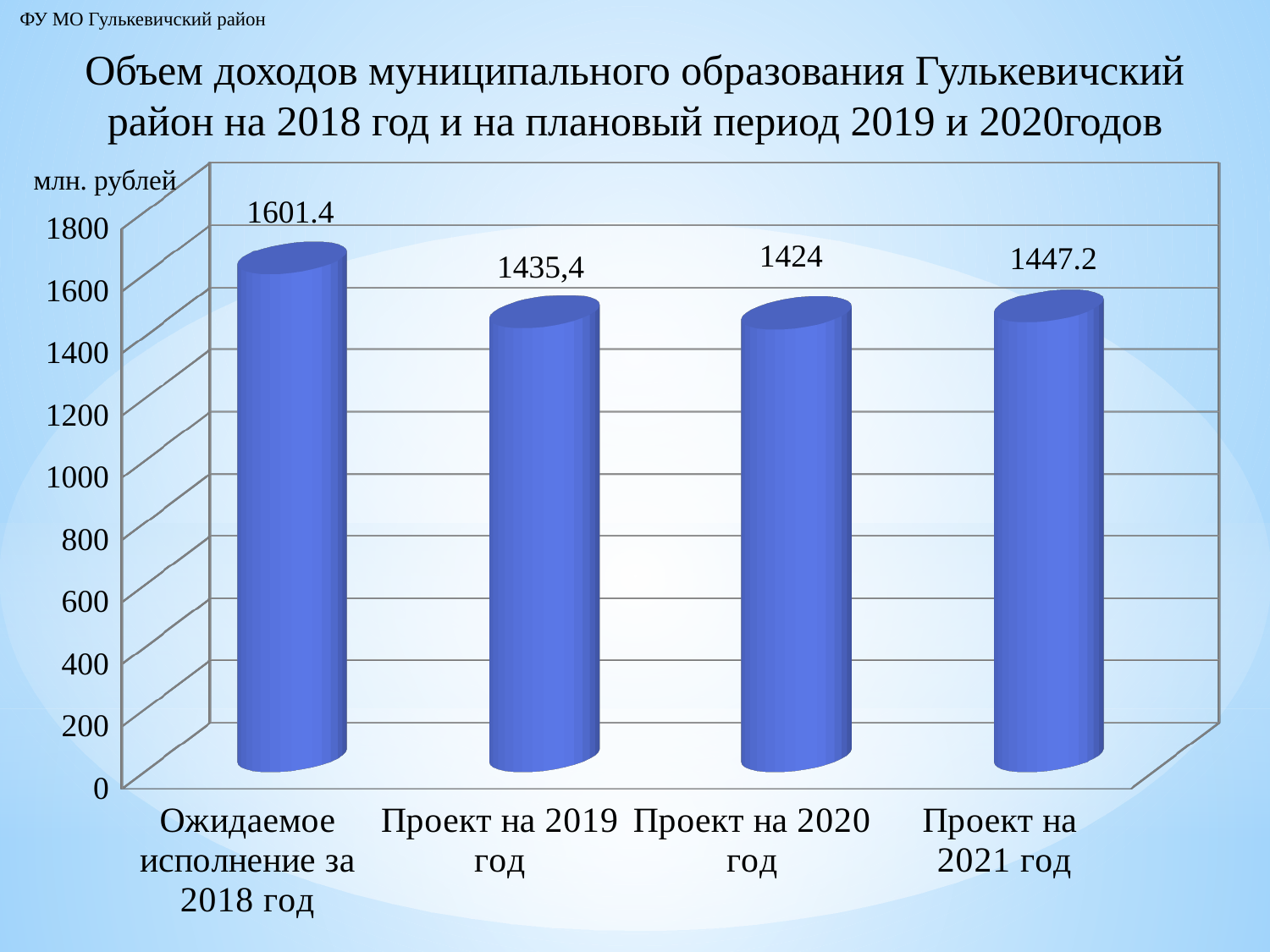
What is the value for "Проект на 2021 год"? 1447.2 What is the value for "Проект на 2020 год"? 1424 How many categories are shown on the chart? 4 Which is larger, the value for "Проект на 2019 год" or the value for "Проект на 2020 год"? Проект на 2019 год What is the value for "Ожидаемое исполнение за 2018 год"? 1601.4 Which category has the lowest value? Проект на 2020 год What is the difference between the values for "Проект на 2021 год" and "Проект на 2020 год"? 23.2 What kind of chart is shown on the slide? Bar chart What unit of measurement is indicated on the chart? млн. рублей Which category has the highest value? Ожидаемое исполнение за 2018 год What is the value for "Проект на 2019 год"? 1435,4 What is the difference between the values for "Ожидаемое исполнение за 2018 год" and "Проект на 2019 год"? 166